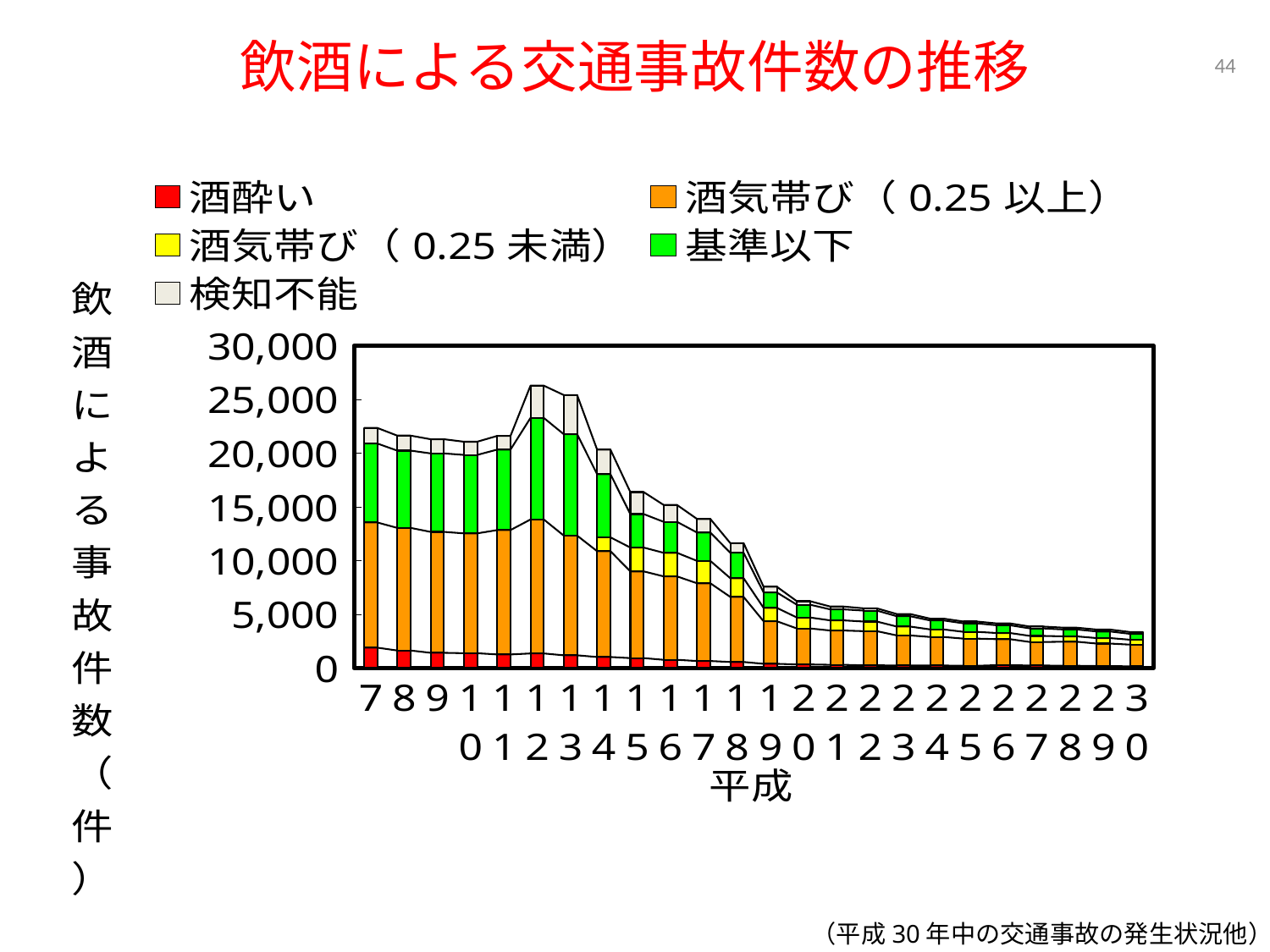
Is the total for 平成 20 greater or less than 10,000? less Overall, do the totals rise or fall from 平成 12 to 平成 30? fall How many years (bars) are plotted along the x axis? 24 Which year (平成) has the tallest stacked bar? 12 What kind of chart is shown on the slide? Stacked bar chart How many series does the legend list? 5 Is the total for 平成 7 greater or less than 20,000? greater Is the total for 平成 12 greater or less than 20,000? greater Which has the larger total, 平成 7 or 平成 20? 平成 7 Which series is shown in red in the legend? 酒酔い What is the title of the chart? 飲酒による交通事故件数の推移